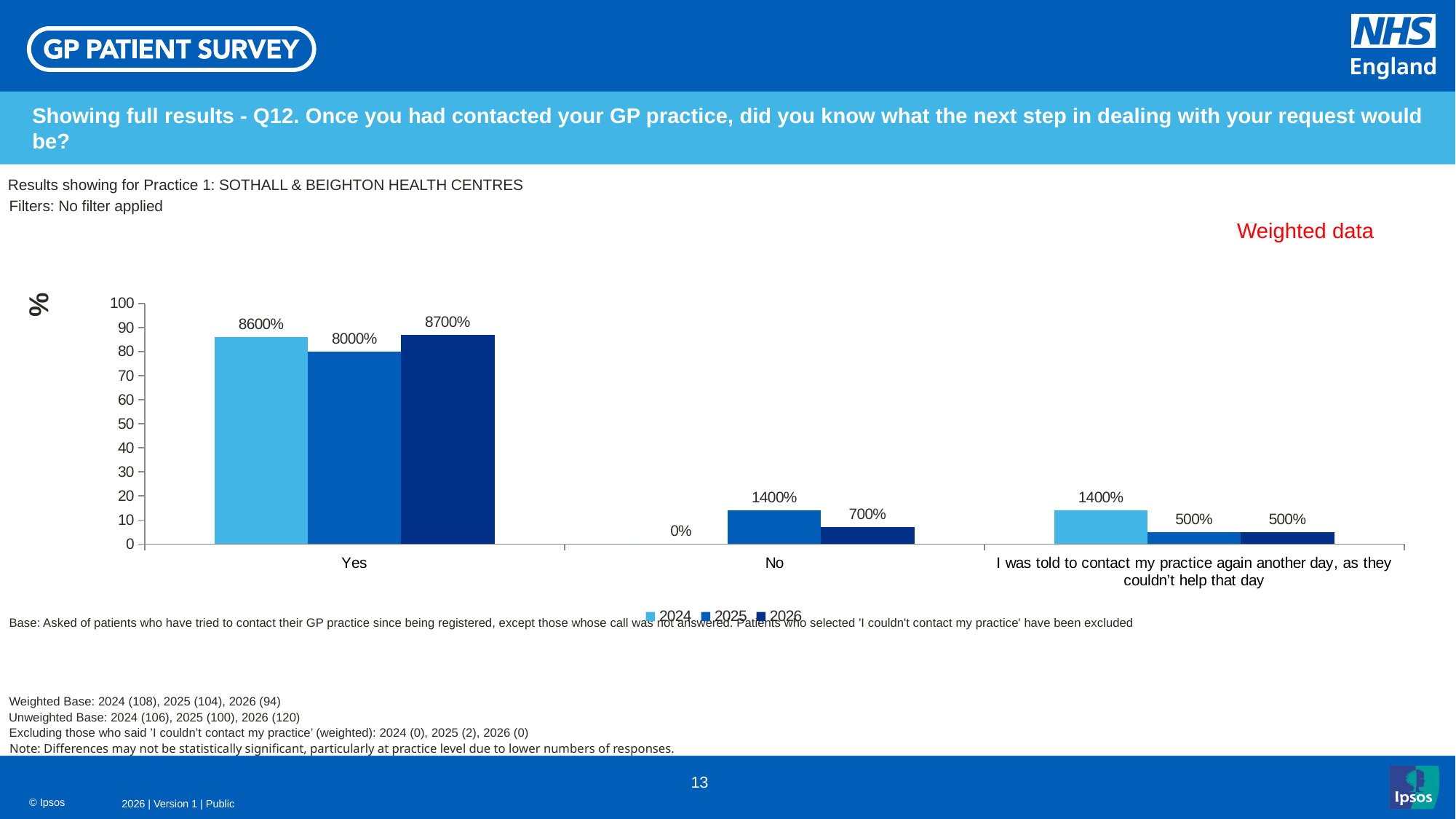
In the 'No' category, which is larger: the 2025 bar or the 2026 bar? 2025 How many series does the legend list? 3 What kind of chart is shown on the slide? Bar chart How many response categories are shown on the x axis? 3 What is the data label for the 2024 series in the 'Yes' category? 8600% Which year has the lowest bar in the 'Yes' category? 2025 Is the 2025 bar for 'Yes' greater or less than 70 on the axis? greater What is the data label for the 2026 series in the 'No' category? 700% What is the data label for the 2025 series in the 'Yes' category? 8000% What is the data label for the 2024 series in the 'No' category? 0% Which year has the highest bar in the 'Yes' category? 2026 What is the data label for the 2025 series in the 'I was told to contact my practice again another day, as they couldn't help that day' category? 500%